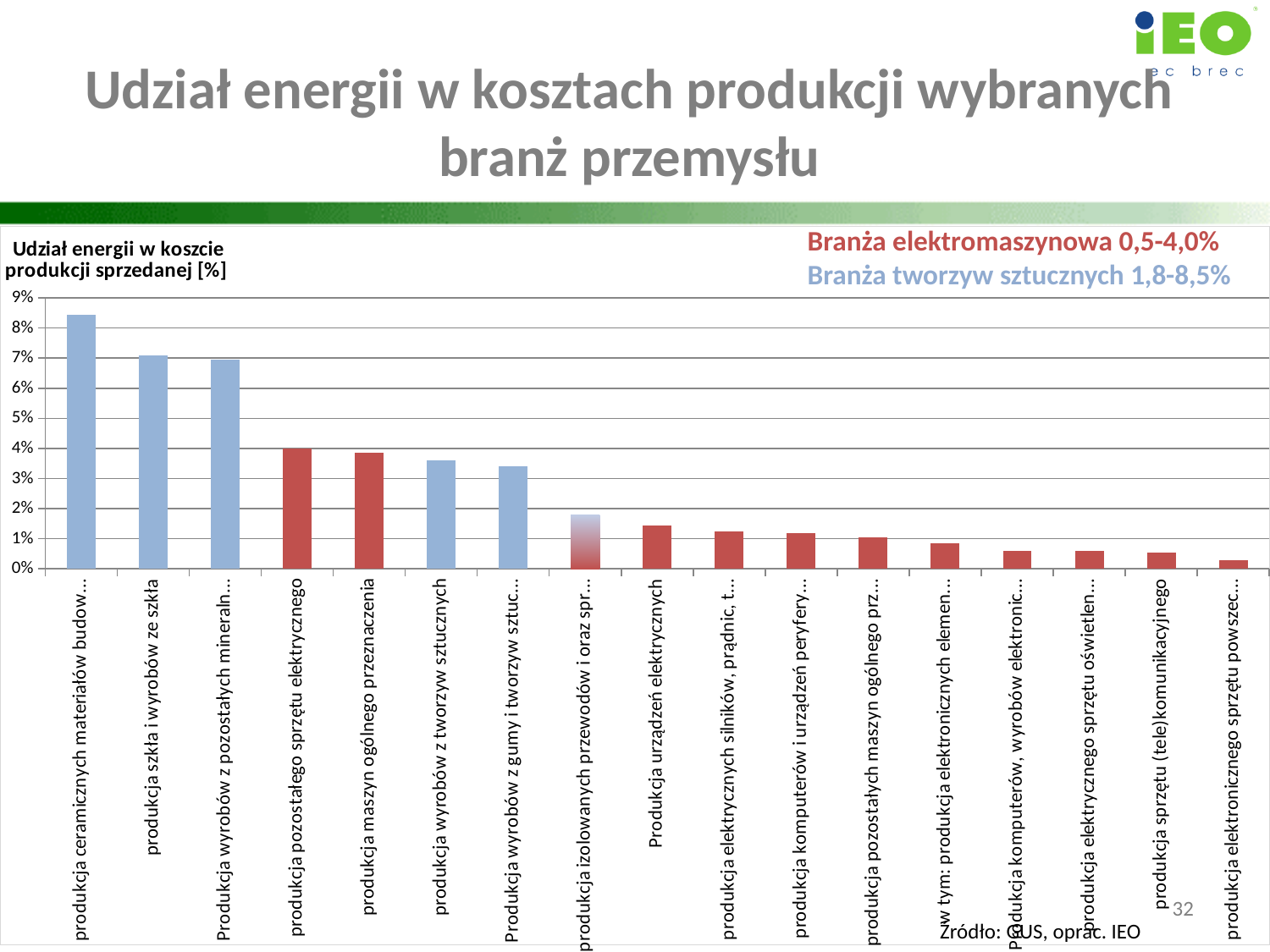
What kind of chart is shown on the slide? bar chart Which is larger: the value for 'Produkcja urządzeń elektrycznych' or for 'produkcja pozostałego sprzętu elektrycznego'? produkcja pozostałego sprzętu elektrycznego Which is larger: the value for 'produkcja szkła i wyrobów ze szkła' or for 'produkcja maszyn ogólnego przeznaczenia'? produkcja szkła i wyrobów ze szkła What is the highest tick value shown on the vertical axis? 9% Is the value for 'produkcja sprzętu (tele)komunikacyjnego' greater or less than 1%? less Is the value for 'produkcja wyrobów z tworzyw sztucznych' greater or less than 4%? less Is the value for 'Produkcja urządzeń elektrycznych' greater or less than 1%? greater What range is given on the slide for 'Branża elektromaszynowa'? 0,5-4,0% Do the bar values generally rise or fall from left to right along the x axis? fall How many bars (categories) are plotted in the chart? 17